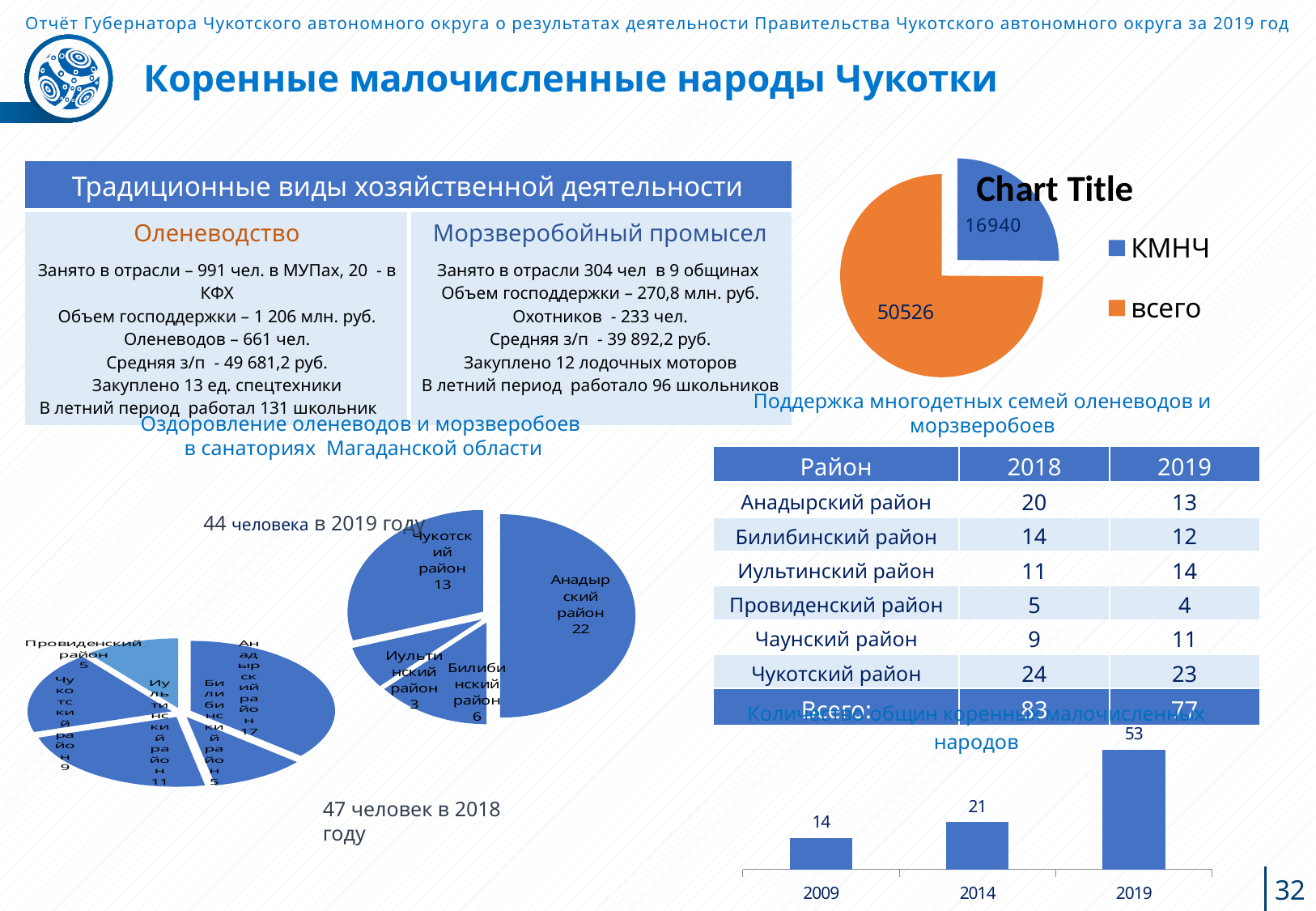
In the bar chart 'Количество общин коренных малочисленных народов', what is the value for 2009? 14 In the pie chart titled 'Chart Title' at the top right, which slice is larger, КМНЧ or всего? всего In the bar chart 'Количество общин коренных малочисленных народов', which year has the lowest value? 2009 How many entries does the legend of the pie chart titled 'Chart Title' list? 2 How many bars are in the bar chart 'Количество общин коренных малочисленных народов'? 3 In the pie chart '47 человек в 2018 году', what is the value for Иультинский район? 11 In the bar chart 'Количество общин коренных малочисленных народов', do the values rise or fall from 2009 to 2019? rise In the bar chart 'Количество общин коренных малочисленных народов', what is the value for 2019? 53 In the pie chart '44 человека в 2019 году', what is the value for Анадырский район? 22 What kind of chart is 'Количество общин коренных малочисленных народов'? bar chart In the pie chart titled 'Chart Title' at the top right, what is the value for КМНЧ? 16940 In the bar chart 'Количество общин коренных малочисленных народов', what is the difference between the 2019 and 2014 values? 32